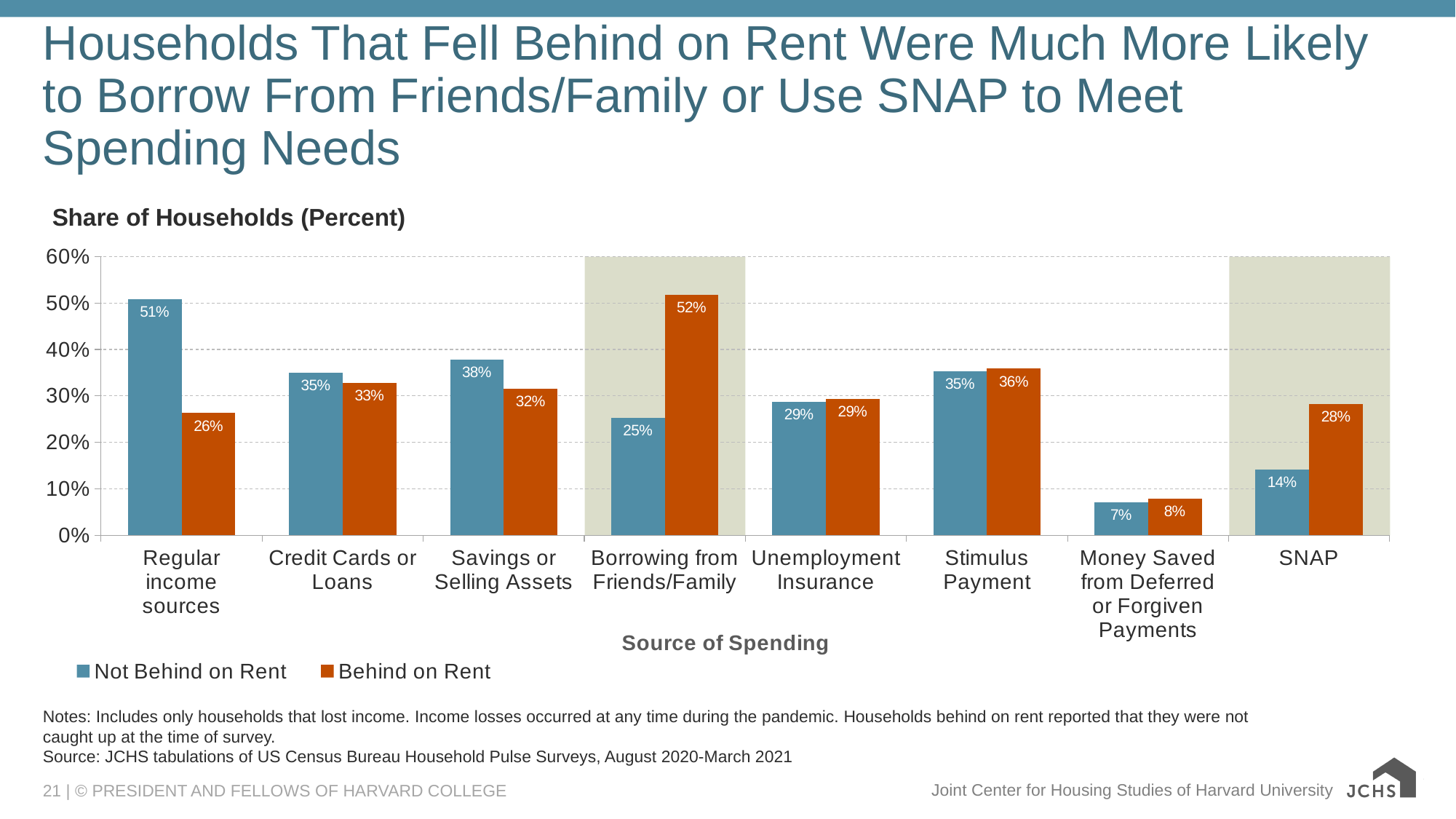
Which source of spending has the highest value for Behind on Rent households? Borrowing from Friends/Family What is the value for Not Behind on Rent households for SNAP? 14% What is the difference between the Behind on Rent and Not Behind on Rent values for SNAP? 14% What is the value for Behind on Rent households for Borrowing from Friends/Family? 52% How many series does the legend list? 2 What is the difference between the Not Behind on Rent and Behind on Rent values for Regular income sources? 25% What kind of chart is shown on the slide? Bar chart How many sources of spending are shown on the x axis? 8 Which source of spending has the lowest value for Not Behind on Rent households? Money Saved from Deferred or Forgiven Payments For Savings or Selling Assets, which group has the larger value: Not Behind on Rent or Behind on Rent? Not Behind on Rent What is the value for Not Behind on Rent households for Regular income sources? 51% What is the label of the x axis? Source of Spending